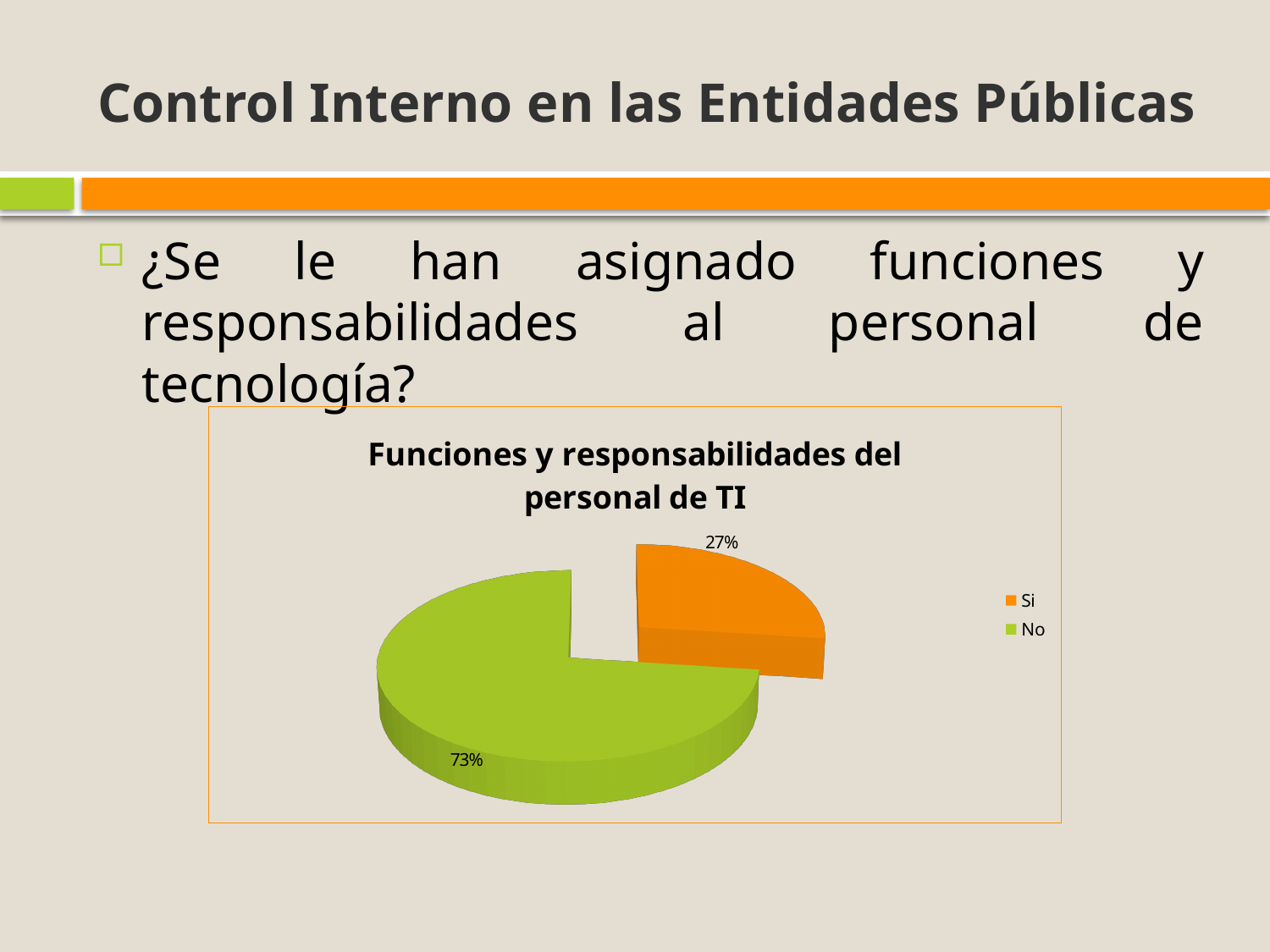
What kind of chart is shown on the slide? pie chart What is the title of the chart? Funciones y responsabilidades del personal de TI What percentage is shown for the "Si" slice? 27% What is the difference in percentage points between the "No" and "Si" slices? 46 What share of the pie does the "No" slice represent? 73% Which category has the largest share of the pie? No How many entries does the legend list? 2 Which slice is larger, "Si" or "No"? No What colour is the "Si" slice? orange Which category has the smallest share of the pie? Si What percentage is shown for the "No" slice? 73% How many slices does the pie chart have? 2